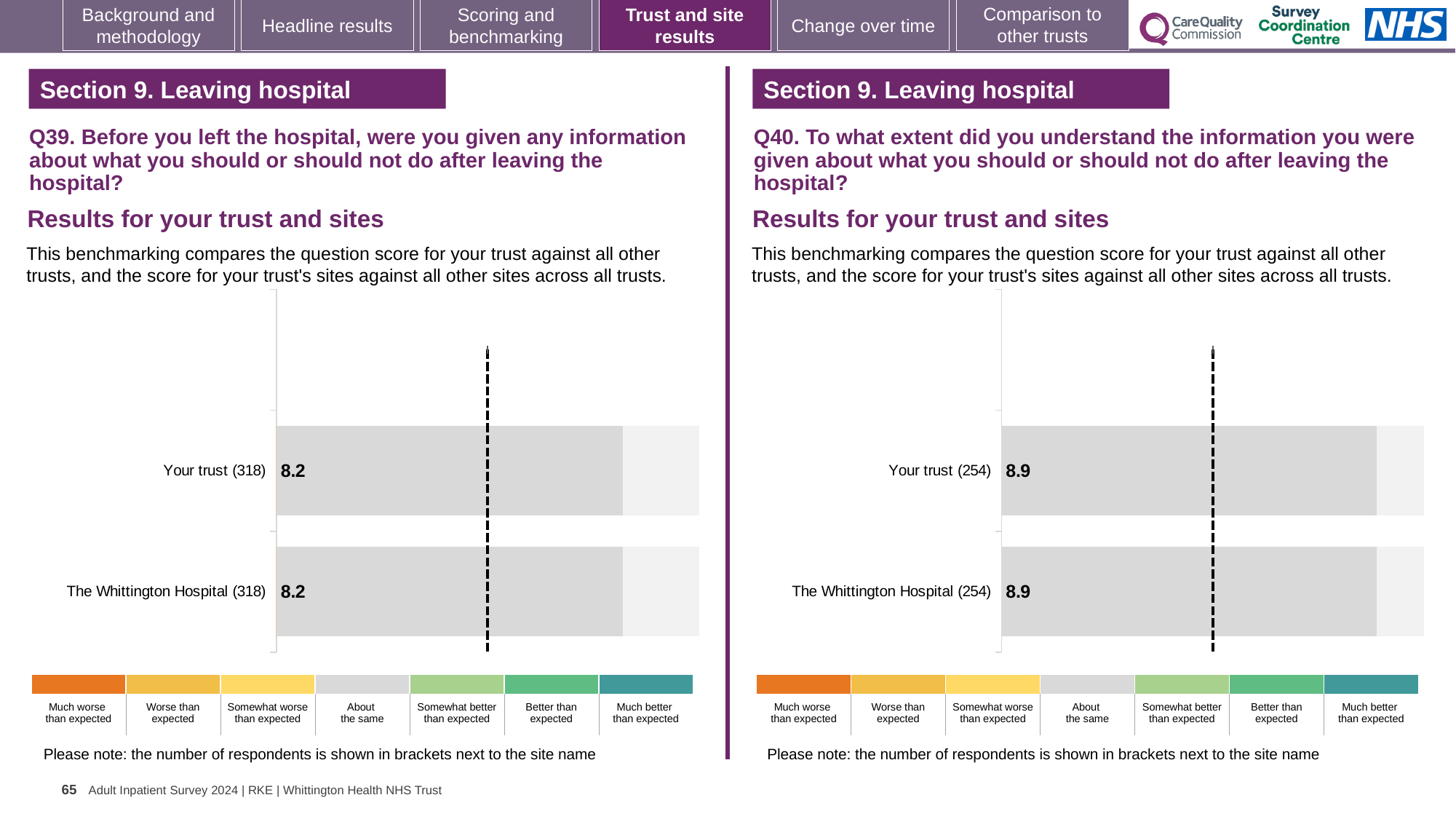
On the Q39 chart (left), how many respondents are shown in brackets next to Your trust? 318 How many categories does the colour key below the Q40 chart (right) list? 7 On the Q39 chart (left), what is the score for Your trust? 8.2 On the Q40 chart (right), how many respondents are shown in brackets next to The Whittington Hospital? 254 On the Q39 chart (left), what is the score for The Whittington Hospital? 8.2 On the Q40 chart (right), what is the score for Your trust? 8.9 On the Q40 chart (right), how many bars are plotted? 2 On the Q39 chart (left), which benchmark category does the Your trust bar fall into according to the colour key? About the same Is the Your trust score on the Q40 chart (right) larger or smaller than the Your trust score on the Q39 chart (left)? Larger On the Q40 chart (right), what is the score for The Whittington Hospital? 8.9 What kind of chart is the Q39 chart (left)? Bar chart On the Q39 chart (left), what is the difference between the score for Your trust and the score for The Whittington Hospital? 0